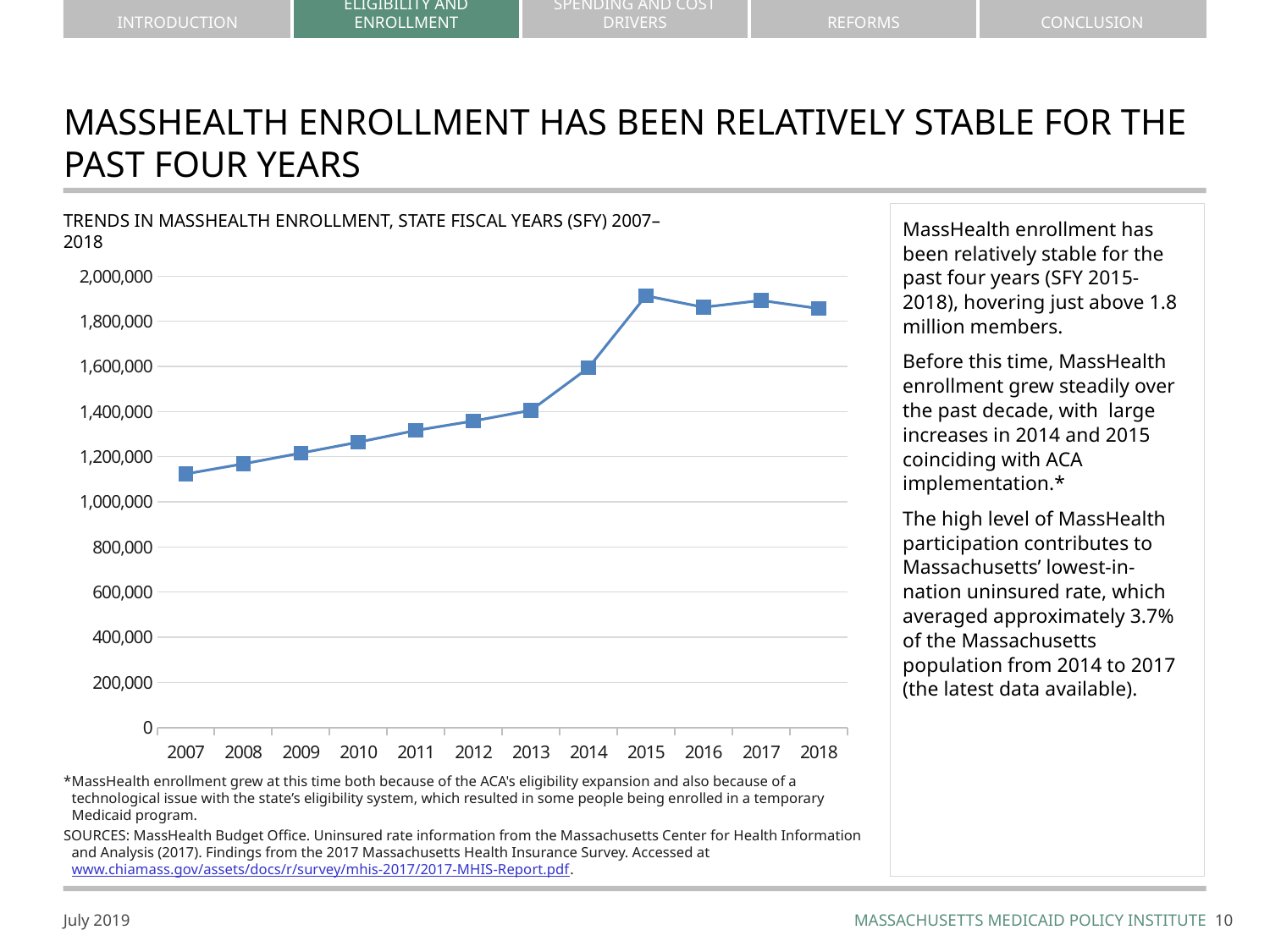
Is the enrollment value for 2007 greater or less than 1,200,000? less Is the enrollment value for 2018 greater or less than 2,000,000? less What kind of chart is shown on the slide? line chart Does MassHealth enrollment rise or fall from 2007 to 2015? rise Which year has the larger enrollment, 2013 or 2014? 2014 How many years (data points) are plotted on the chart? 12 Which year has the lowest MassHealth enrollment on the chart? 2007 Is the enrollment value for 2014 greater or less than 1,400,000? greater What is the title of the chart? TRENDS IN MASSHEALTH ENROLLMENT, STATE FISCAL YEARS (SFY) 2007–2018 Which year has the larger enrollment, 2009 or 2016? 2016